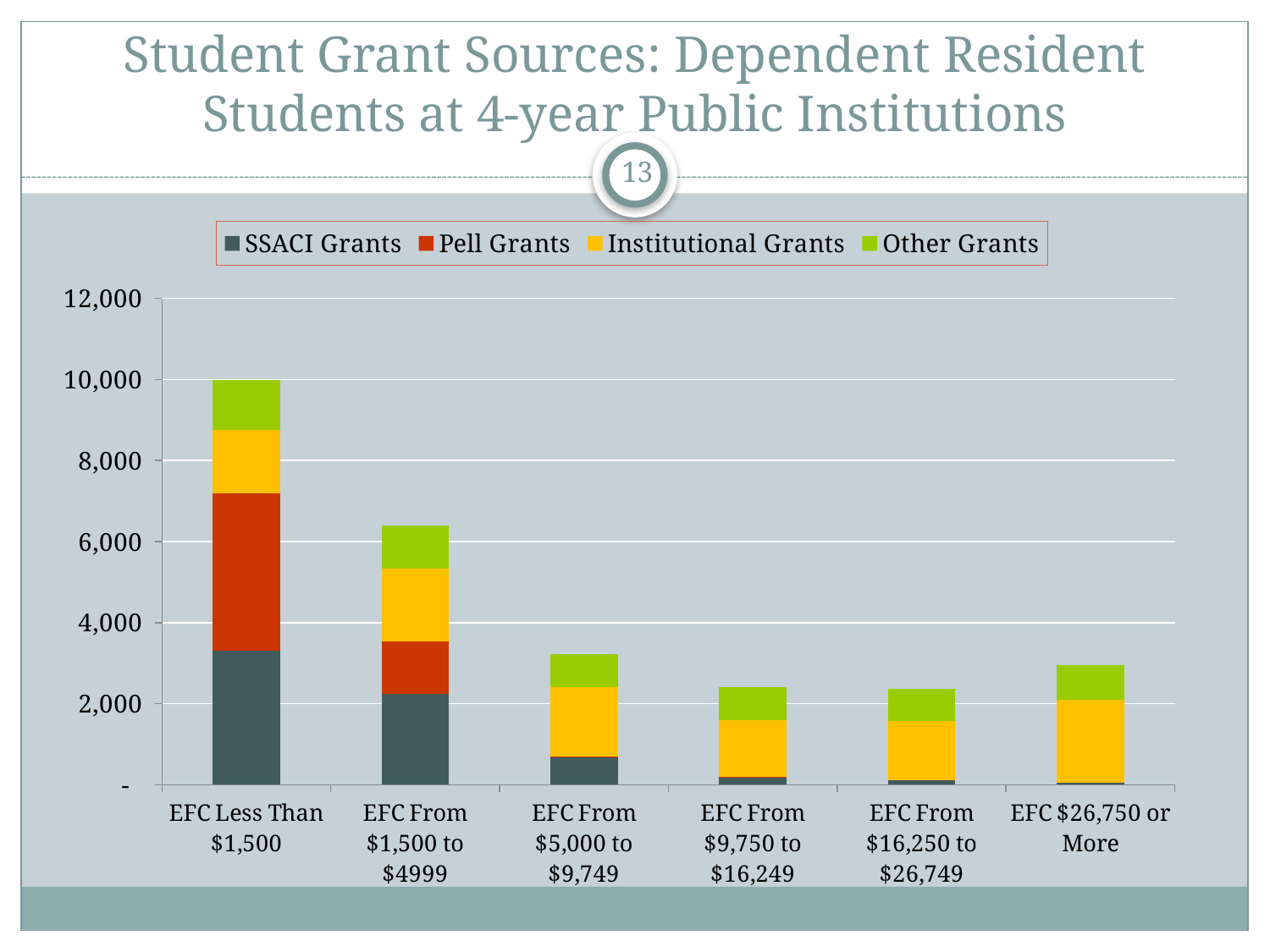
Do the total stacked bars rise or fall from EFC Less Than $1,500 through EFC From $16,250 to $26,749? fall Which series is shown at the bottom of each stacked bar? SSACI Grants Is the total stacked bar for EFC Less Than $1,500 greater or less than 8,000? greater How many EFC categories are shown on the x axis? 6 What are the four series listed in the legend? SSACI Grants, Pell Grants, Institutional Grants, Other Grants Which EFC category has the tallest stacked bar? EFC Less Than $1,500 Which has the larger total stacked bar: EFC Less Than $1,500 or EFC From $1,500 to $4999? EFC Less Than $1,500 Is the total stacked bar for EFC From $1,500 to $4999 greater or less than 8,000? less What kind of chart is shown on the slide? Stacked bar chart Is the total stacked bar for EFC $26,750 or More greater or less than 2,000? greater How many series does the legend list? 4